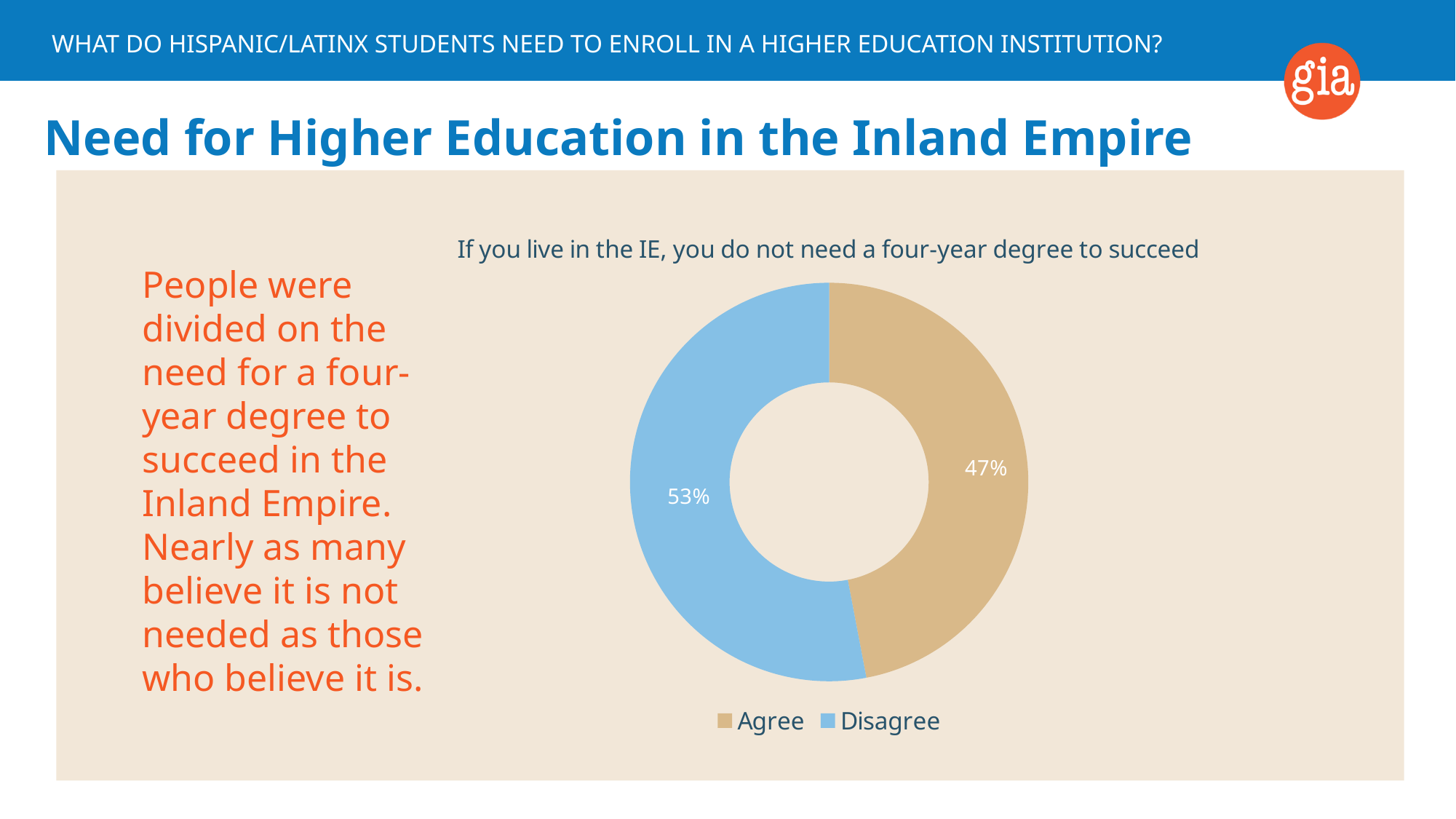
What percentage of respondents agree that if you live in the IE, you do not need a four-year degree to succeed? 47% Which colour represents Disagree in the chart? Blue What is the difference in percentage points between the Disagree and Agree shares? 6 percentage points How many entries does the chart legend list? 2 What is the title of the chart? If you live in the IE, you do not need a four-year degree to succeed Which response has the larger share of the chart, Agree or Disagree? Disagree Is the value for Disagree greater or less than 50%? greater Which response has the smaller share of the chart? Agree What percentage of respondents disagree that if you live in the IE, you do not need a four-year degree to succeed? 53% What type of chart is shown on the slide? Doughnut (pie) chart Is the Agree share larger or smaller than the Disagree share? smaller How many categories are shown in the chart? 2